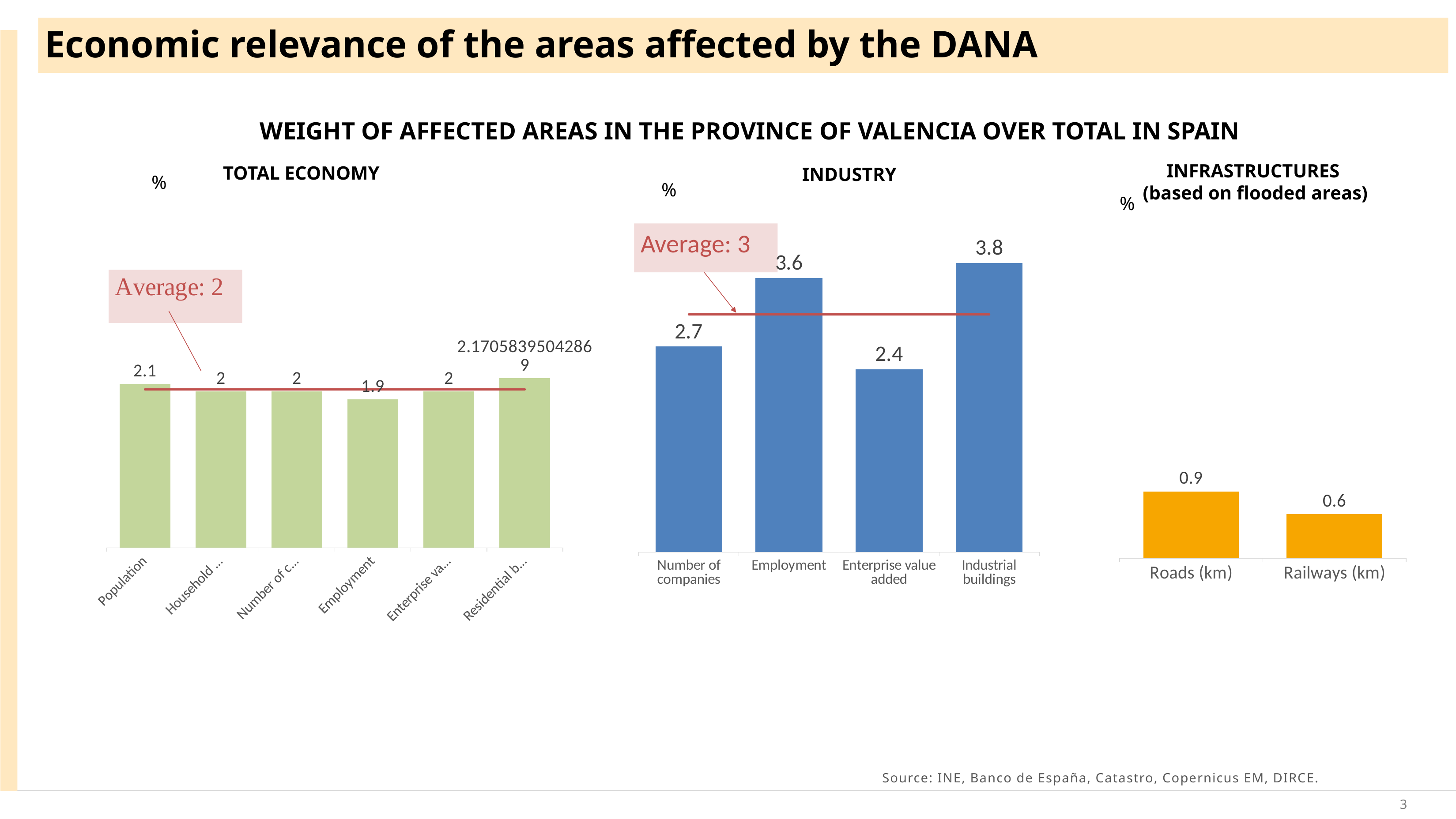
In the TOTAL ECONOMY chart, what is the value for Population? 2.1 In the INDUSTRY chart, what is the value for Number of companies? 2.7 In the TOTAL ECONOMY chart, what is the value for Employment? 1.9 In the INFRASTRUCTURES chart, what is the value for Roads (km)? 0.9 In the INDUSTRY chart, how many categories are shown? 4 In the INDUSTRY chart, which category has the highest value? Industrial buildings In the INFRASTRUCTURES chart, what is the difference between Roads (km) and Railways (km)? 0.3 In the INFRASTRUCTURES chart, which is larger, Roads (km) or Railways (km)? Roads (km) In the INDUSTRY chart, what is the difference between Industrial buildings and Enterprise value added? 1.4 What type of chart is the INFRASTRUCTURES chart? Bar chart In the INDUSTRY chart, which category has the lowest value? Enterprise value added In the INDUSTRY chart, what is the value for Employment? 3.6